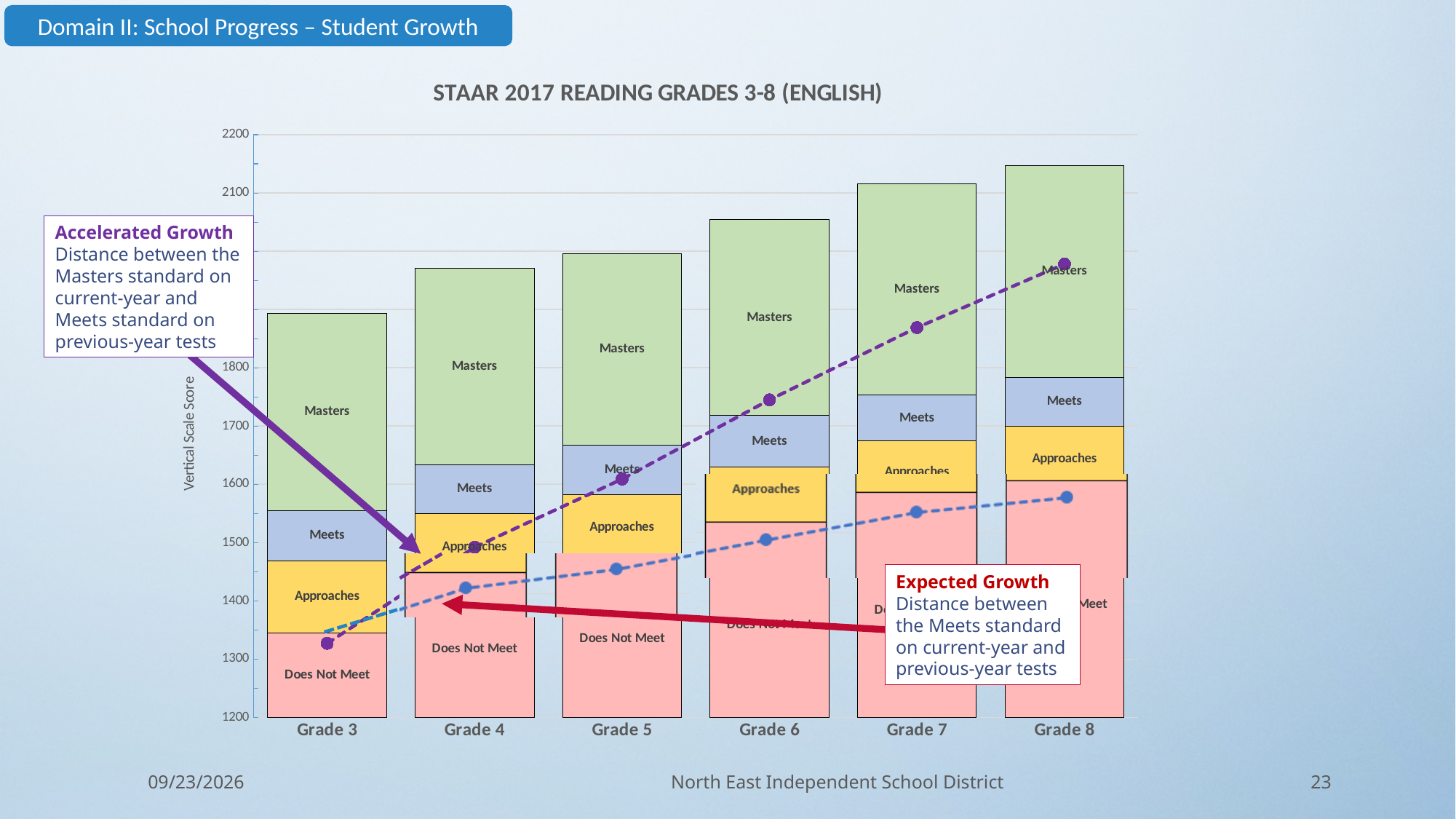
What is the label on the vertical axis of the chart? Vertical Scale Score Is the top of the Grade 8 bar greater or less than 2100? greater Which bar is taller, Grade 3 or Grade 8? Grade 8 Is the top of the Grade 6 bar greater or less than 2000? greater Do the bar heights rise or fall from Grade 3 to Grade 8? Rise Which grade has the shortest bar in the chart? Grade 3 What is the title of the chart? STAAR 2017 READING GRADES 3-8 (ENGLISH) How many grade categories are shown on the x axis of the chart? 6 What type of chart is shown on the slide? Combination stacked bar and line chart Is the top of the Grade 4 bar greater or less than 2000? less Which grade has the tallest bar in the chart? Grade 8